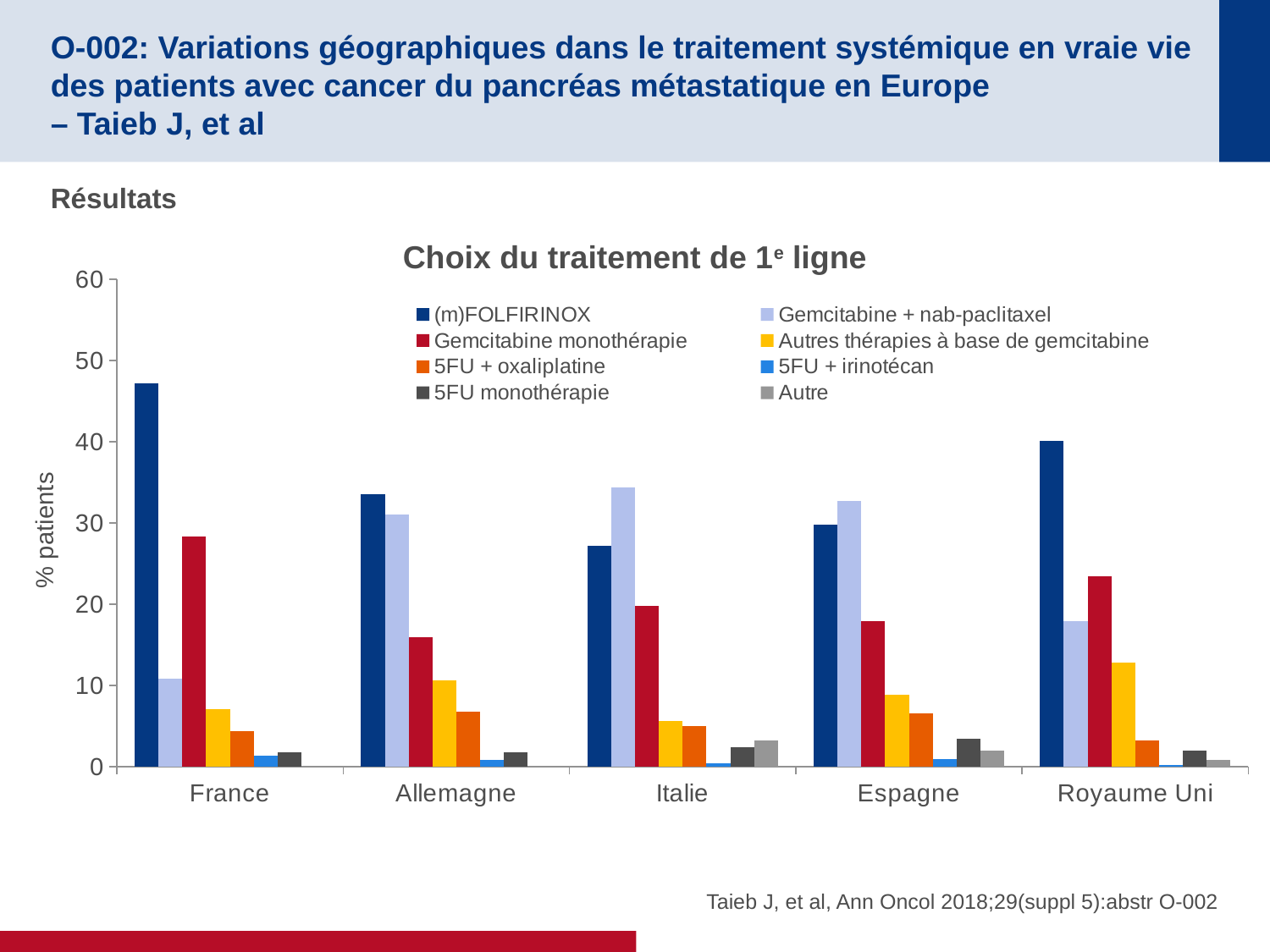
In France, which is larger: Gemcitabine monothérapie or Gemcitabine + nab-paclitaxel? Gemcitabine monothérapie How many series does the chart legend list? 8 Is the value for (m)FOLFIRINOX in France greater or less than 40? greater Is the value for Gemcitabine monothérapie in Allemagne greater or less than 20? less Is the value for Gemcitabine + nab-paclitaxel in Italie greater or less than 30? greater What is the title of the chart? Choix du traitement de 1e ligne Which country has the lowest value for Gemcitabine + nab-paclitaxel? France In Italie, which is larger: (m)FOLFIRINOX or Gemcitabine + nab-paclitaxel? Gemcitabine + nab-paclitaxel How many countries are shown on the x axis of the chart? 5 What kind of chart is shown on the slide? Bar chart Which country has the highest value for (m)FOLFIRINOX? France